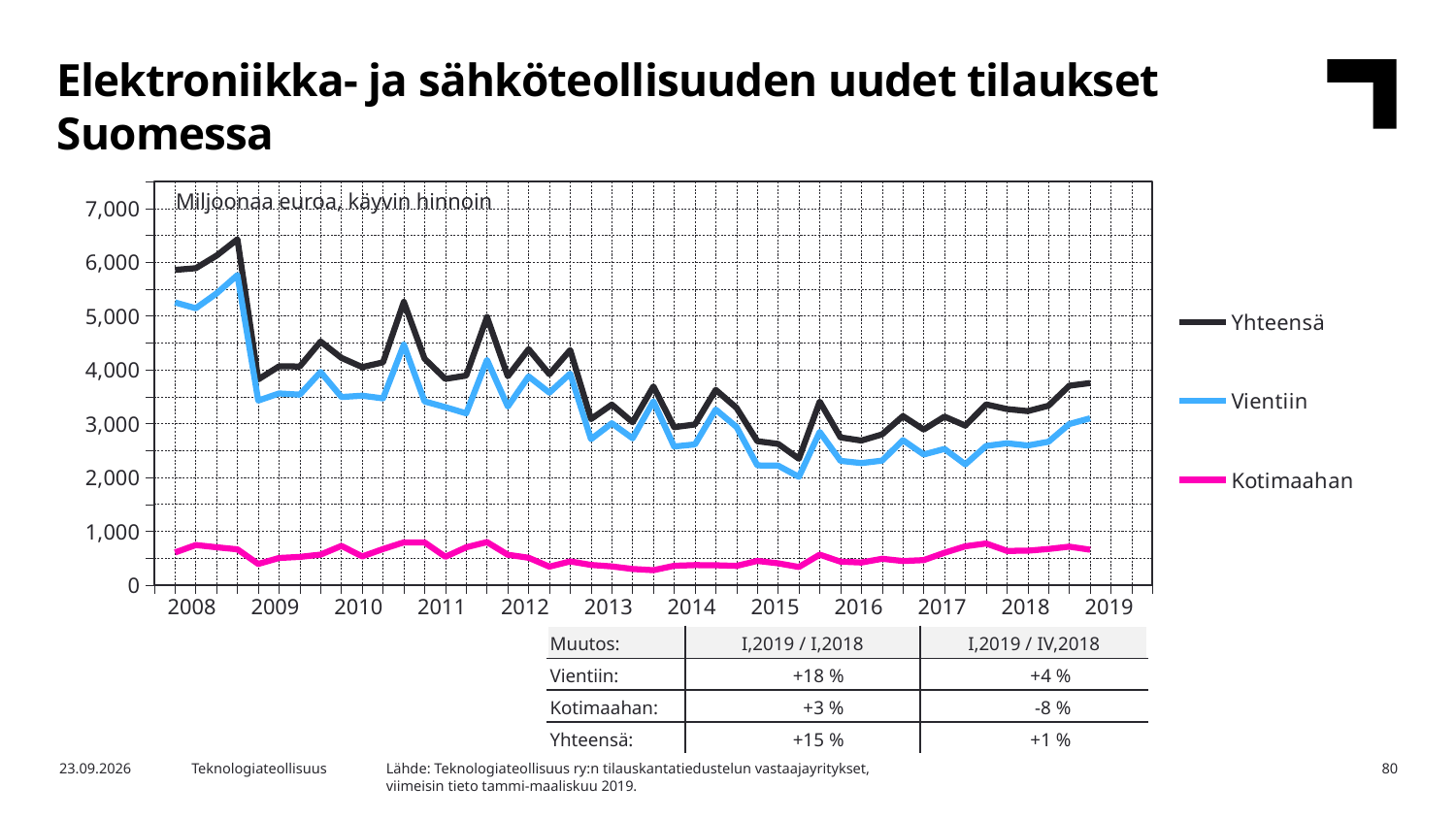
Is the value for Kotimaahan in 2008 greater or less than 1,000? less How many years are labelled on the x axis? 12 How many series does the legend list? 3 Overall, do the Yhteensä values rise or fall from 2008 to 2019? fall Which series is plotted with the highest values throughout the chart? Yhteensä Which series is plotted with the lowest values throughout the chart? Kotimaahan What kind of chart is shown on the slide? line chart Is the value for Yhteensä at the start of 2008 greater or less than 5,000? greater Is the value for Yhteensä in 2019 greater or less than 3,000? greater What unit is stated in the text at the top of the chart area? Miljoonaa euroa, käyvin hinnoin In 2012, which is larger: the value for Vientiin or the value for Kotimaahan? Vientiin